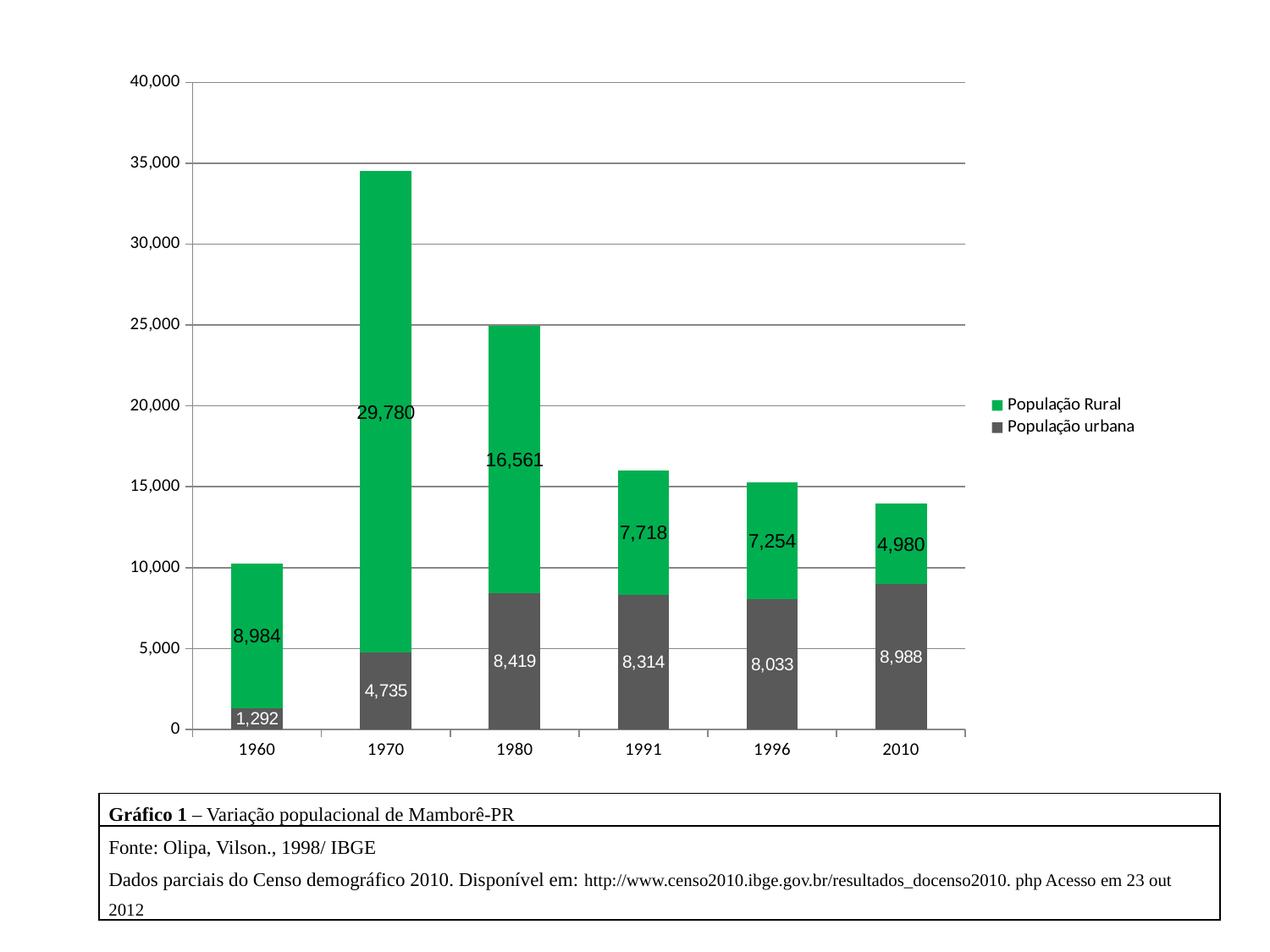
In which year is População urbana lowest? 1960 What is the total population (both series combined) in 1970? 34,515 Which is larger in 1996, População Rural or População urbana? População urbana What is the value of População urbana in 1960? 1,292 What is the value of População urbana in 2010? 8,988 How many years are shown on the x axis? 6 How many series does the legend list? 2 What kind of chart is this? Stacked bar chart In which year is População Rural highest? 1970 What is the total population (both series combined) in 2010? 13,968 What is the difference between População Rural in 1980 and in 1991? 8,843 What is the value of População Rural in 1970? 29,780